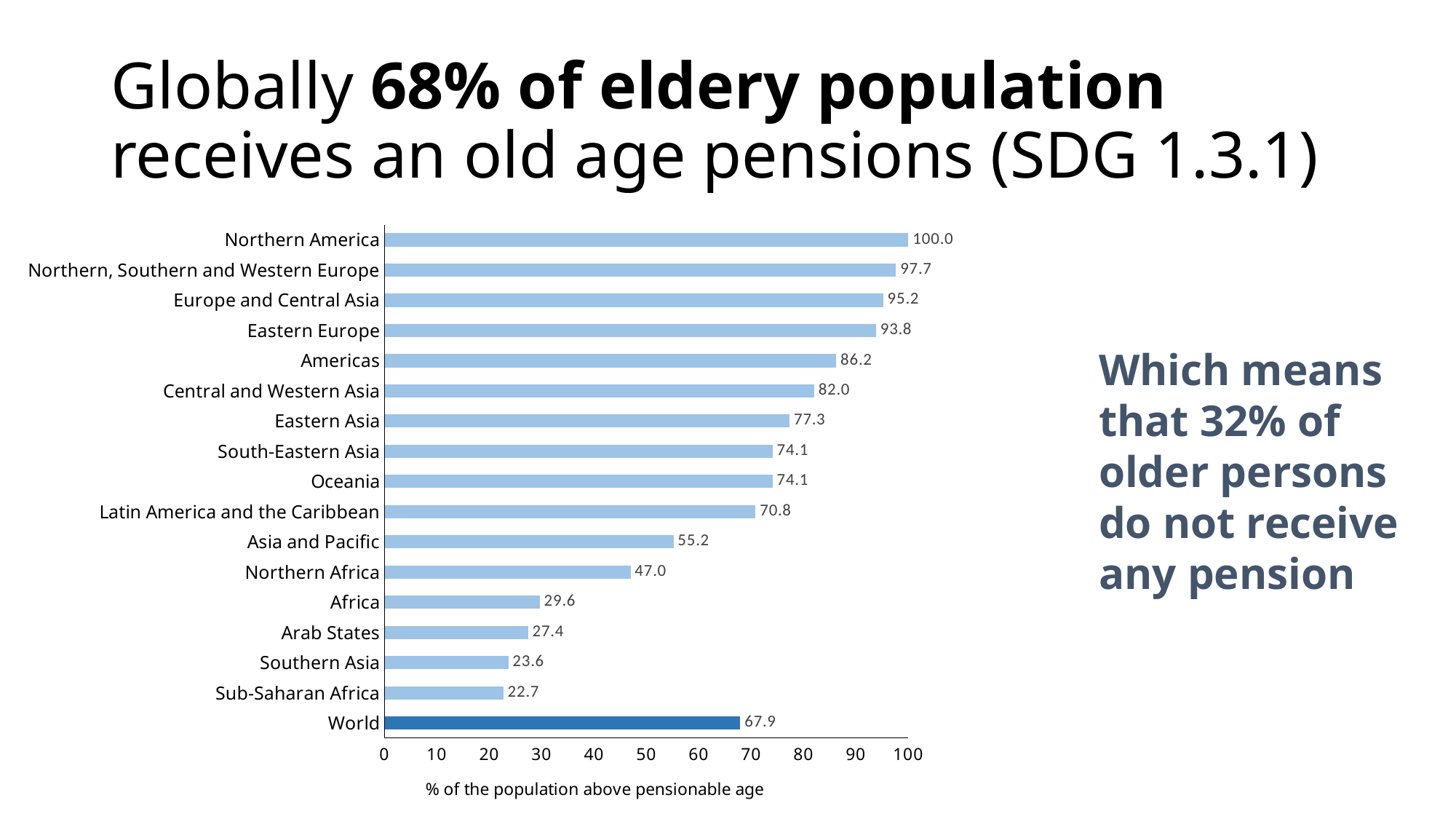
Which category has the highest value? Northern America What is the difference between the values for Northern America and Sub-Saharan Africa? 77.3 Which category has the lowest value? Sub-Saharan Africa What is the value for Latin America and the Caribbean? 70.8 Is the value for Asia and Pacific greater or less than 50? greater What is the value for Northern America? 100.0 What is the difference between the values for Eastern Asia and Northern Africa? 30.3 What is the value for World? 67.9 How many categories are shown in the chart? 17 What kind of chart is shown on the slide? bar chart What is the value for Sub-Saharan Africa? 22.7 Which is larger, the value for Americas or the value for Central and Western Asia? Americas